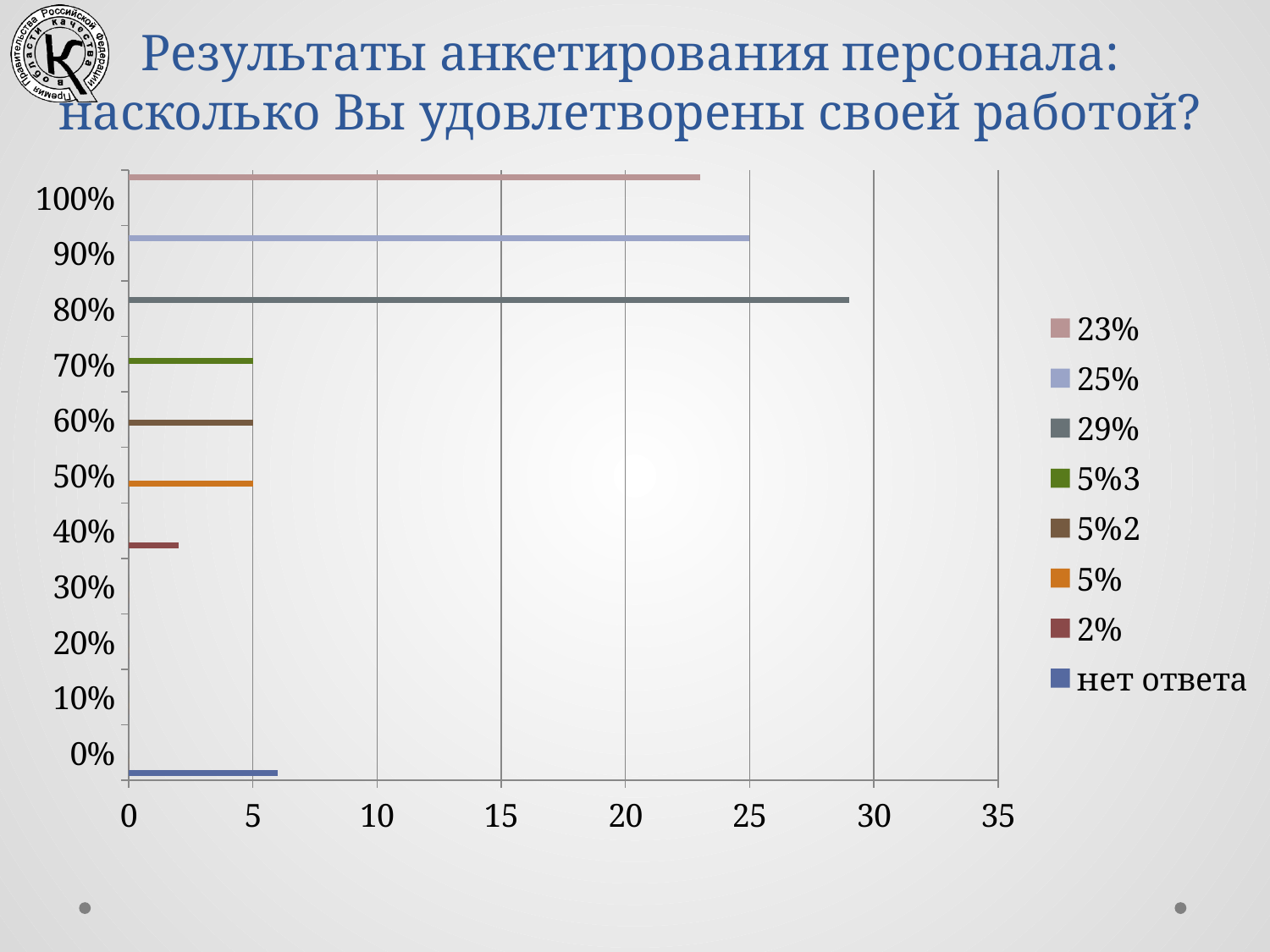
Which series has the shortest bar? 2% Which bar is longer, the one for "29%" or the one for "23%"? 29% Is the value for the series "нет ответа" greater or less than 10? less How many series does the legend list? 8 What is the value of the bar for the series "5%"? 5 Is the value for the series "29%" greater or less than 25? greater What is the title of the slide containing the chart? Результаты анкетирования персонала: насколько Вы удовлетворены своей работой? Which series has the longest bar? 29% What type of chart is shown on the slide? bar chart What is the value of the bar for the series "25%"? 25 Is the value for the series "23%" greater or less than 20? greater What is the value of the bar for the series "5%3"? 5